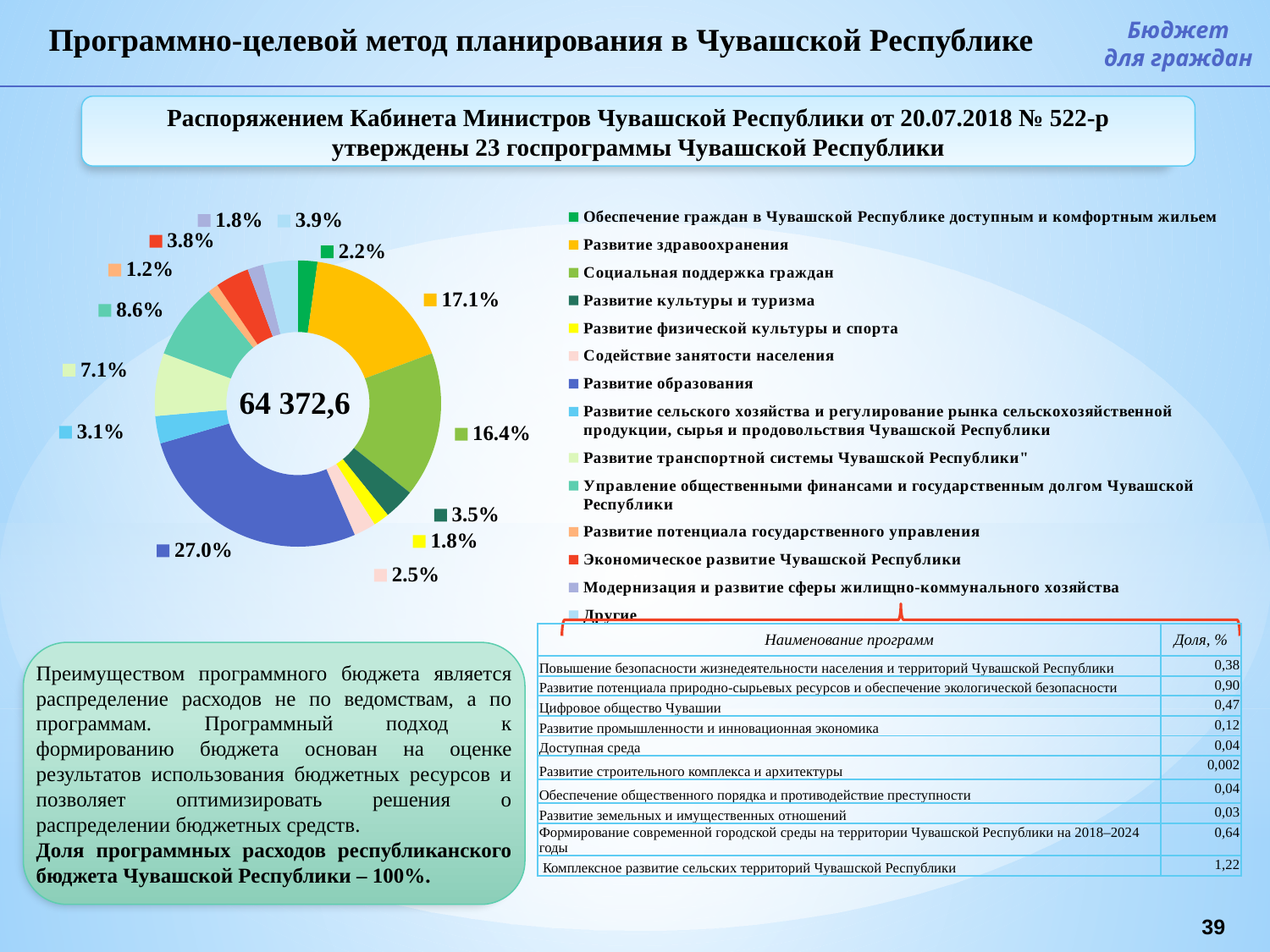
What share of the pie chart is labelled "Другие"? 3.9% What is the difference between the shares of "Развитие образования" and "Развитие здравоохранения"? 9.9% What share of the pie chart does "Развитие образования" have? 27.0% How many entries does the legend of the pie chart list? 14 What share of the pie chart does "Социальная поддержка граждан" have? 16.4% What value is printed in the centre of the pie chart? 64 372,6 Which is larger in the pie chart: "Управление общественными финансами и государственным долгом Чувашской Республики" or "Развитие транспортной системы Чувашской Республики"? Управление общественными финансами и государственным долгом Чувашской Республики What colour is the slice for "Развитие образования" in the pie chart? Blue Which programme has the largest slice in the pie chart? Развитие образования What kind of chart is shown on the slide? Pie chart (donut) Which programme has the smallest slice in the pie chart? Развитие потенциала государственного управления